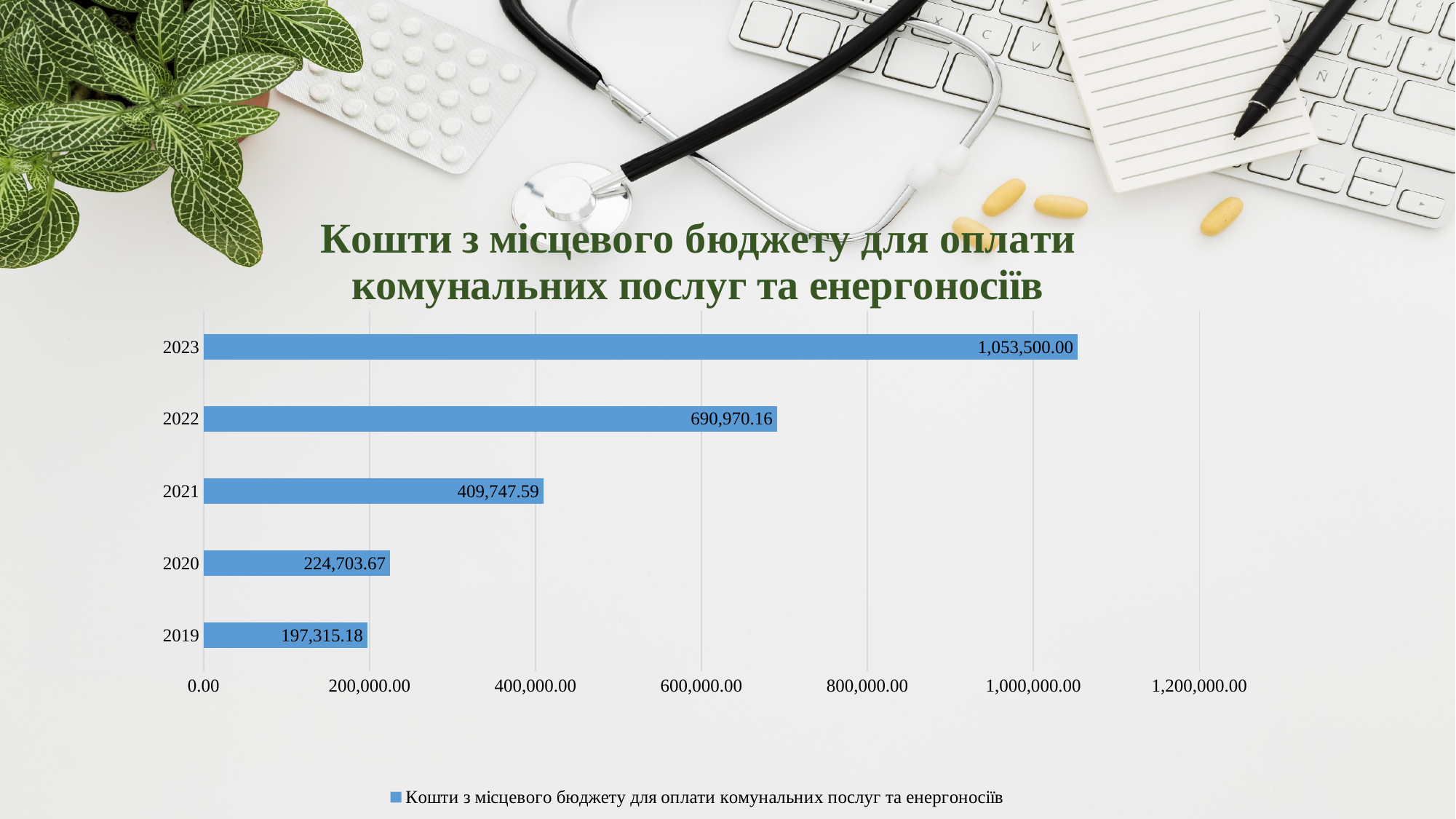
How many years are shown in the chart? 5 What is the value for 2019? 197,315.18 Which year has the highest value? 2023 Which is larger, the value for 2022 or the value for 2021? 2022 What is the value for 2023? 1,053,500.00 Do the values increase or decrease from 2019 to 2023? increase What is the difference between the values for 2023 and 2022? 362,529.84 Is the value for 2022 greater or less than 600,000.00? greater What kind of chart is shown on the slide? bar chart What is the value for 2021? 409,747.59 Which year has the lowest value? 2019 What is the difference between the values for 2020 and 2019? 27,388.49